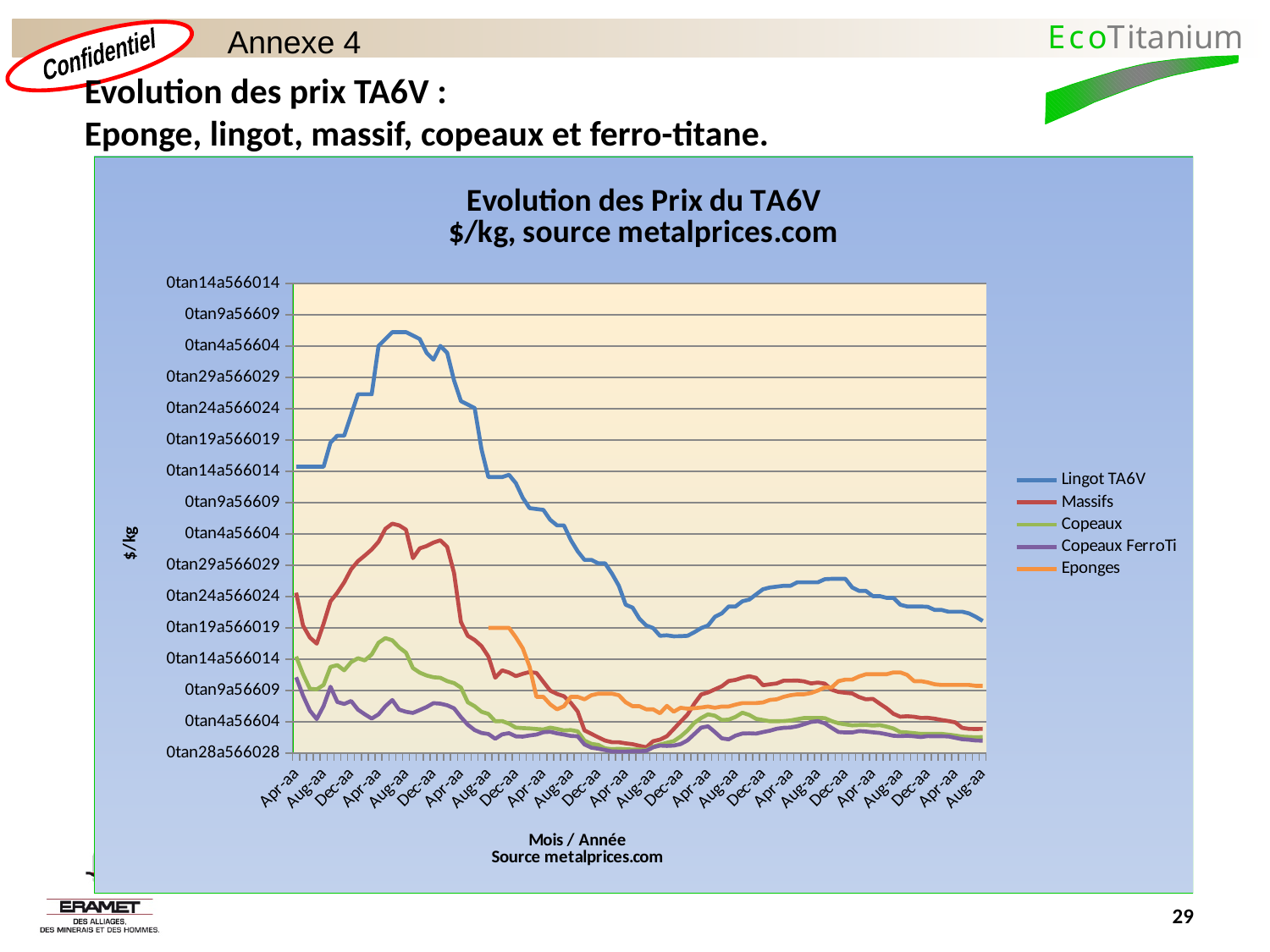
Does the Lingot TA6V line rise or fall immediately after its highest peak? fall Does the Eponges line rise or fall over its first few points? fall How many series does the legend list? 5 What is the title of the chart? Evolution des Prix du TA6V $/kg, source metalprices.com What are the series names listed in the legend? Lingot TA6V, Massifs, Copeaux, Copeaux FerroTi, Eponges Which series is higher at its peak, Lingot TA6V or Massifs? Lingot TA6V Which series reaches the highest values on the chart? Lingot TA6V Which series stays lowest on the chart? Copeaux FerroTi Does the Lingot TA6V line rise or fall over its first few points? rise Which series is higher at its peak, Massifs or Copeaux? Massifs Which series is higher at its peak, Copeaux or Copeaux FerroTi? Copeaux What kind of chart is shown on the slide? line chart